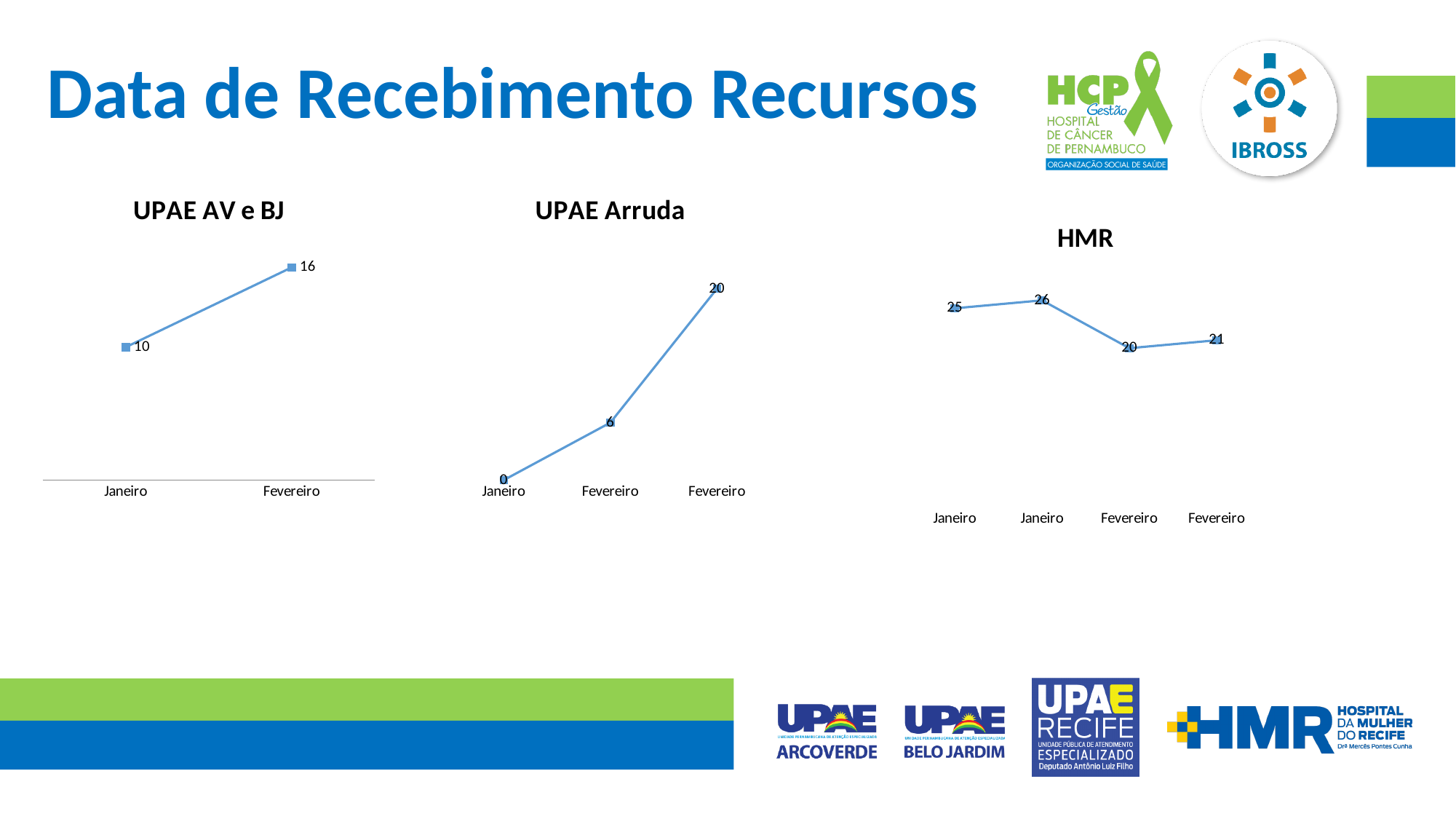
In the UPAE AV e BJ chart, do the values rise or fall from Janeiro to Fevereiro? rise In the HMR chart, what is the lowest value plotted? 20 In the UPAE AV e BJ chart, what is the difference between the Fevereiro and Janeiro values? 6 In the UPAE Arruda chart, how many data points are plotted? 3 In the UPAE Arruda chart, what is the value for Janeiro? 0 In the HMR chart, what is the value of the first data point (the first Janeiro)? 25 What kind of chart is the HMR chart? line chart In the UPAE AV e BJ chart, what is the value for Janeiro? 10 In the UPAE Arruda chart, do the values rise or fall along the x axis? rise In the HMR chart, how many data points are plotted? 4 In the UPAE Arruda chart, what is the highest value plotted? 20 In the UPAE AV e BJ chart, what is the value for Fevereiro? 16